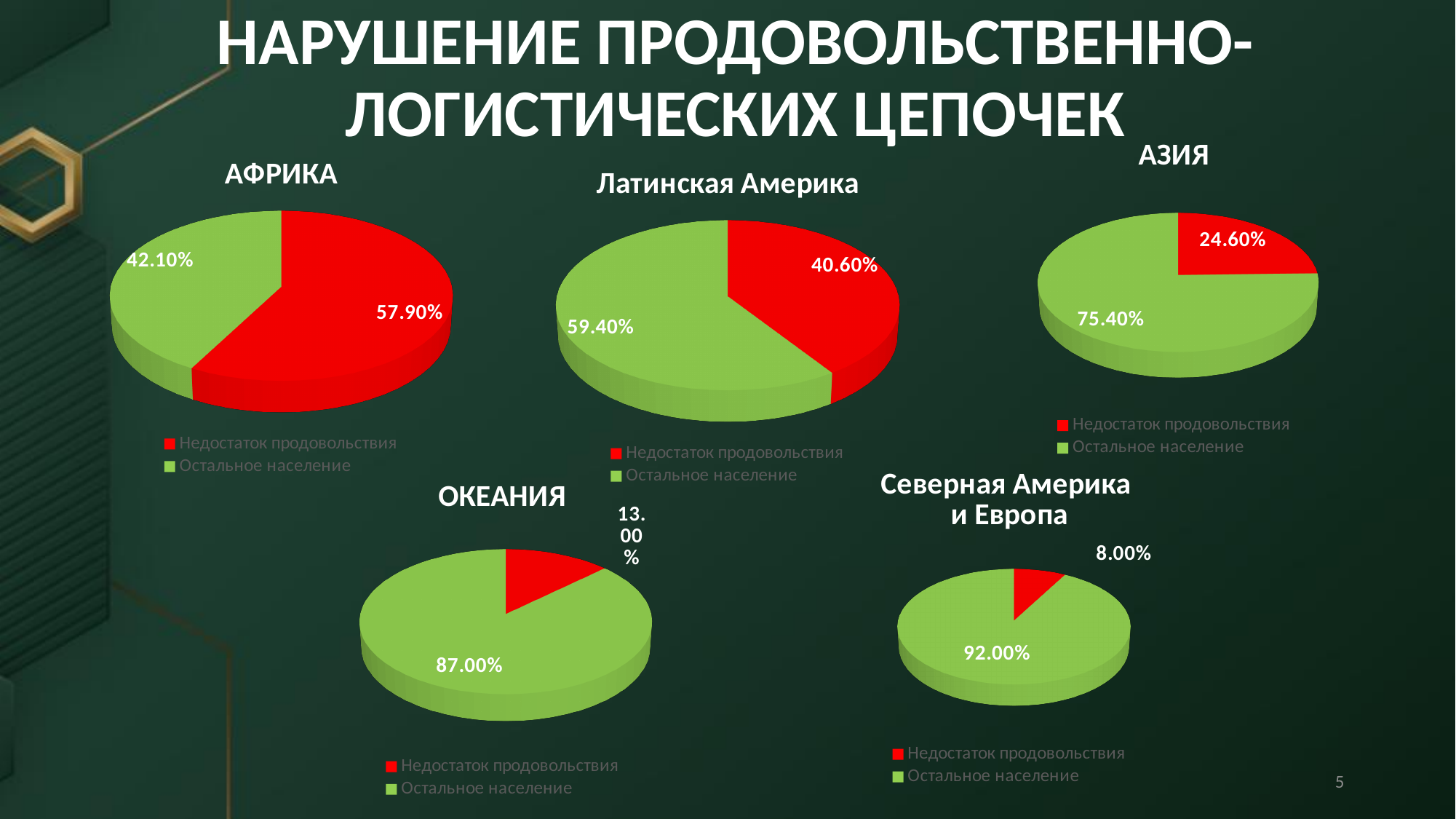
In the Латинская Америка chart, what is the value for Остальное население? 59.40% What kind of chart is the АФРИКА chart? Pie chart In the Северная Америка и Европа chart, what share is shown for Недостаток продовольствия? 8.00% In the ОКЕАНИЯ chart, which slice is the smallest? Недостаток продовольствия How many series does the legend of the АЗИЯ chart list? 2 In the АФРИКА chart, what share is labelled for Недостаток продовольствия? 57.90% In the АФРИКА chart, which slice is larger: Недостаток продовольствия or Остальное население? Недостаток продовольствия In the ОКЕАНИЯ chart, what is the value for Остальное население? 87.00% In the АЗИЯ chart, what share is shown for Недостаток продовольствия? 24.60% In the Северная Америка и Европа chart, what colour is the Остальное население slice? Green In the АЗИЯ chart, what is the difference between Остальное население and Недостаток продовольствия? 50.80% How many slices does the Латинская Америка chart have? 2